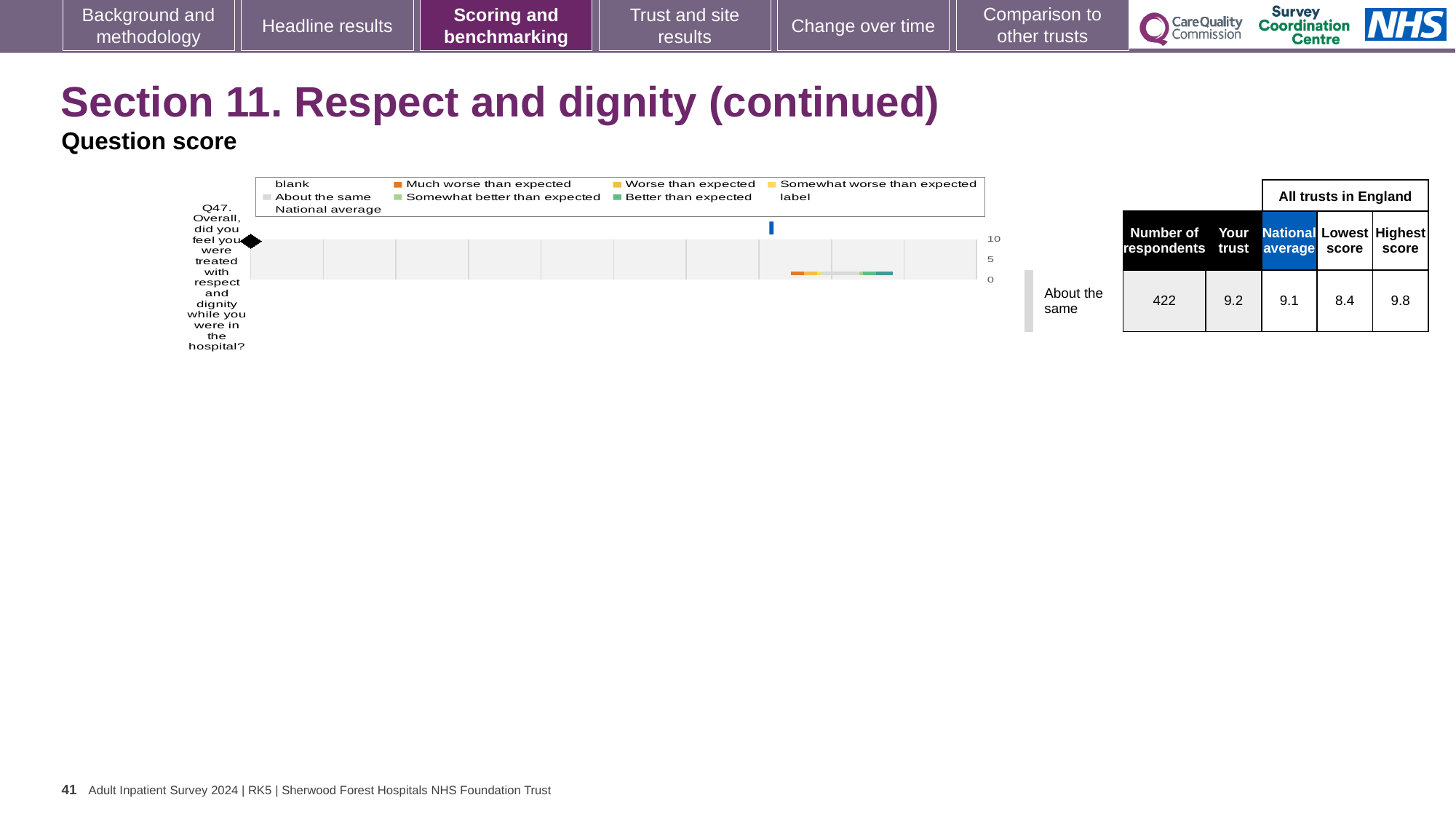
What is the 'Your trust' score for Q47 shown in the table beside the chart? 9.2 How many respondents answered Q47 for this trust? 422 Which is larger for Q47, the 'Your trust' score or the national average? Your trust What is the highest score among all trusts in England for Q47? 9.8 Which benchmarking category is the trust's score for Q47 placed in? About the same What is the national average score for Q47 shown in the table beside the chart? 9.1 What is the highest tick value shown on the chart's axis? 10 Which survey question does the chart on this slide relate to? Q47. Overall, did you feel you were treated with respect and dignity while you were in the hospital? What is the difference between the highest and lowest scores among all trusts in England for Q47? 1.4 What is the lowest score among all trusts in England for Q47? 8.4 By how much does the 'Your trust' score for Q47 exceed the national average? 0.1